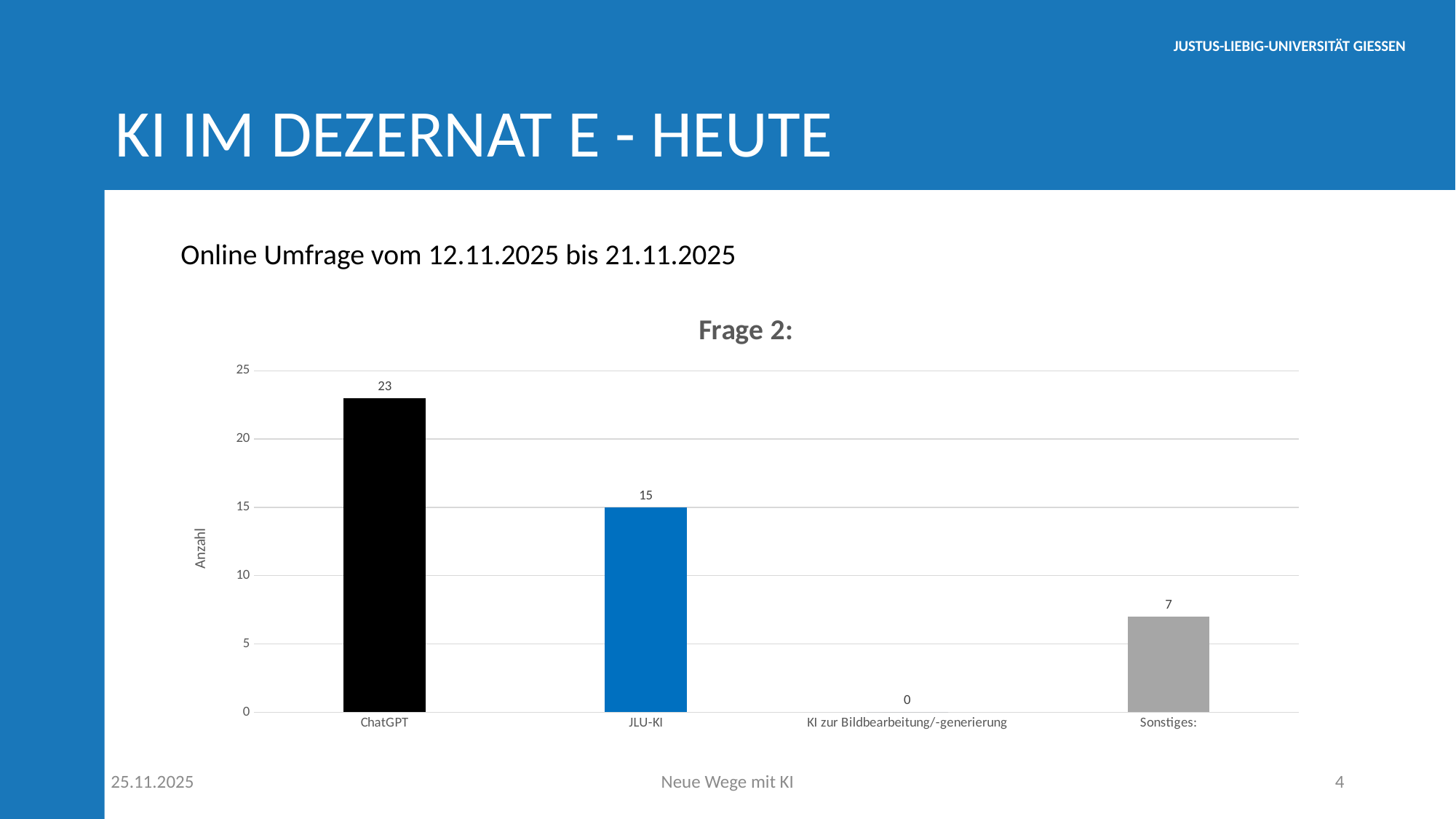
What is the difference between the values for ChatGPT and JLU-KI? 8 Is the value for Sonstiges: greater or less than 10? less What is the value for ChatGPT? 23 What kind of chart is shown? bar chart What is the value for KI zur Bildbearbeitung/-generierung? 0 What is the title of the chart? Frage 2: Which category has the highest value? ChatGPT What is the value for Sonstiges:? 7 Which category has the lowest value? KI zur Bildbearbeitung/-generierung How many categories are shown on the x axis? 4 Which is larger, the value for JLU-KI or the value for Sonstiges:? JLU-KI What is the value for JLU-KI? 15